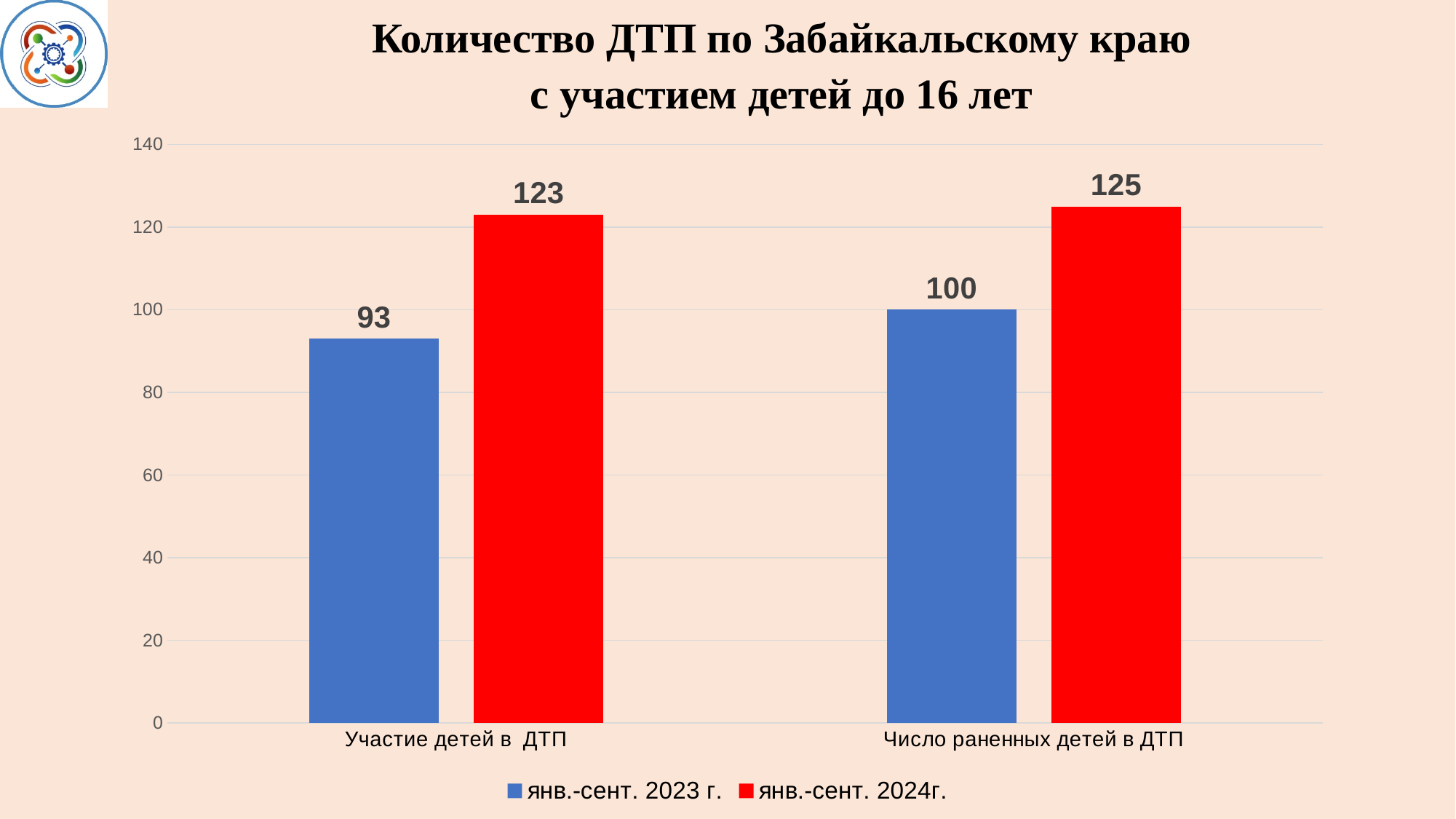
How many categories are shown on the x axis? 2 What is the value for 'Число раненных детей в ДТП' in the 'янв.-сент. 2023 г.' series? 100 Which bar has the highest value on the chart? Число раненных детей в ДТП, янв.-сент. 2024г. What is the difference between the 2024 and 2023 values for 'Число раненных детей в ДТП'? 25 What is the value for 'Участие детей в ДТП' in the 'янв.-сент. 2023 г.' series? 93 Which bar has the lowest value on the chart? Участие детей в ДТП, янв.-сент. 2023 г. How many series does the legend list? 2 What is the value for 'Участие детей в ДТП' in the 'янв.-сент. 2024г.' series? 123 What is the difference between the 2024 and 2023 values for 'Участие детей в ДТП'? 30 What kind of chart is shown on the slide? Bar chart Which is larger for 'Число раненных детей в ДТП': the 'янв.-сент. 2023 г.' value or the 'янв.-сент. 2024г.' value? янв.-сент. 2024г. What is the value for 'Число раненных детей в ДТП' in the 'янв.-сент. 2024г.' series? 125